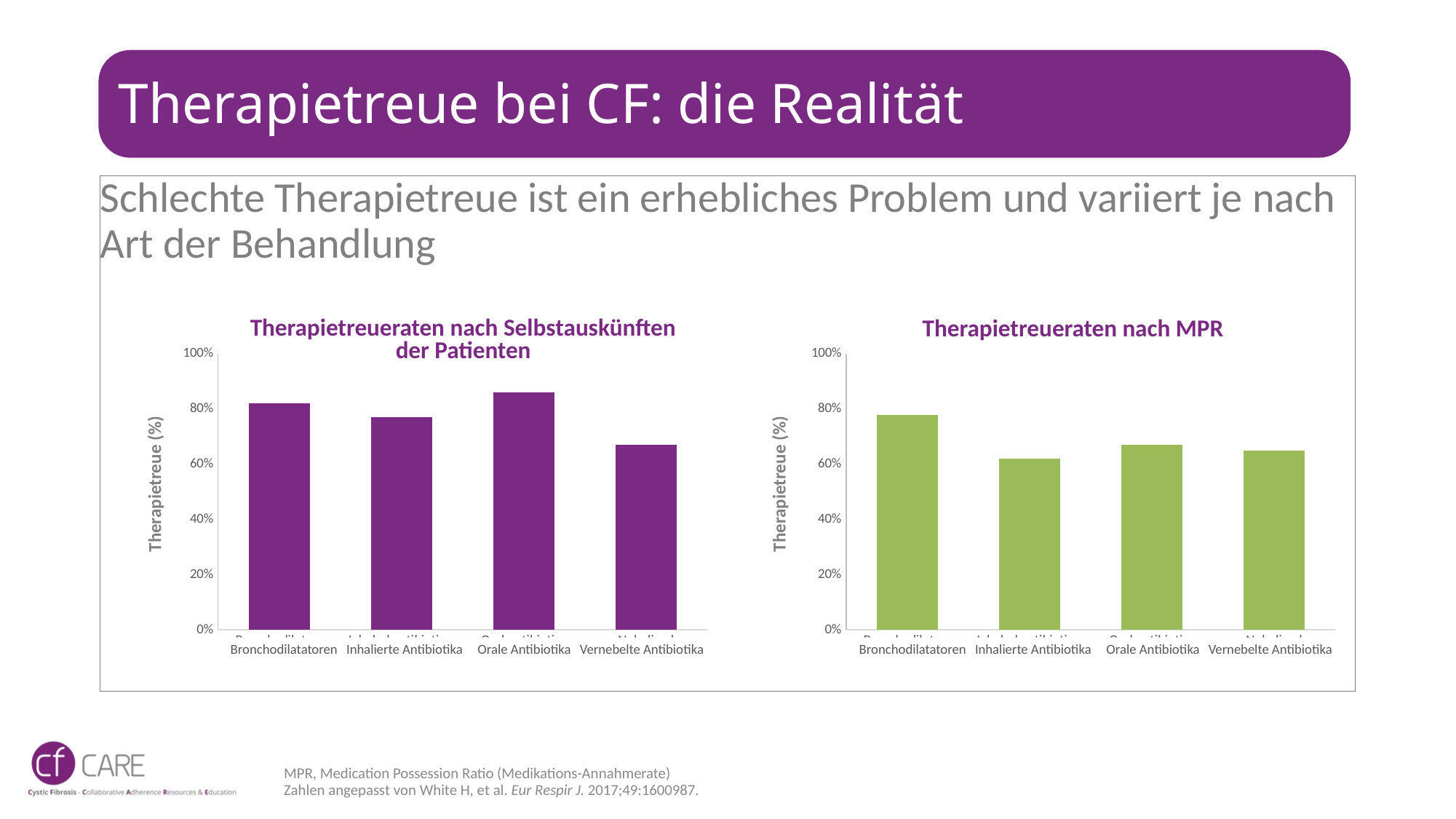
What kind of chart is "Therapietreueraten nach Selbstauskünften der Patienten"? bar chart In the "Therapietreueraten nach MPR" chart, which category has the highest value? Bronchodilatatoren In the "Therapietreueraten nach MPR" chart, which category has the lowest value? Inhalierte Antibiotika In the "Therapietreueraten nach Selbstauskünften der Patienten" chart, which is larger: Inhalierte Antibiotika or Vernebelte Antibiotika? Inhalierte Antibiotika In the "Therapietreueraten nach MPR" chart, is the value for Inhalierte Antibiotika greater or less than 80%? less What is the y-axis label of the "Therapietreueraten nach MPR" chart? Therapietreue (%) In the "Therapietreueraten nach Selbstauskünften der Patienten" chart, which category has the lowest value? Vernebelte Antibiotika In the "Therapietreueraten nach MPR" chart, which is larger: Bronchodilatatoren or Orale Antibiotika? Bronchodilatatoren In the "Therapietreueraten nach Selbstauskünften der Patienten" chart, is the value for Bronchodilatatoren greater or less than 80%? greater In the "Therapietreueraten nach Selbstauskünften der Patienten" chart, which category has the highest value? Orale Antibiotika How many categories are shown in the "Therapietreueraten nach MPR" chart? 4 In the "Therapietreueraten nach MPR" chart, is the value for Bronchodilatatoren greater or less than 60%? greater